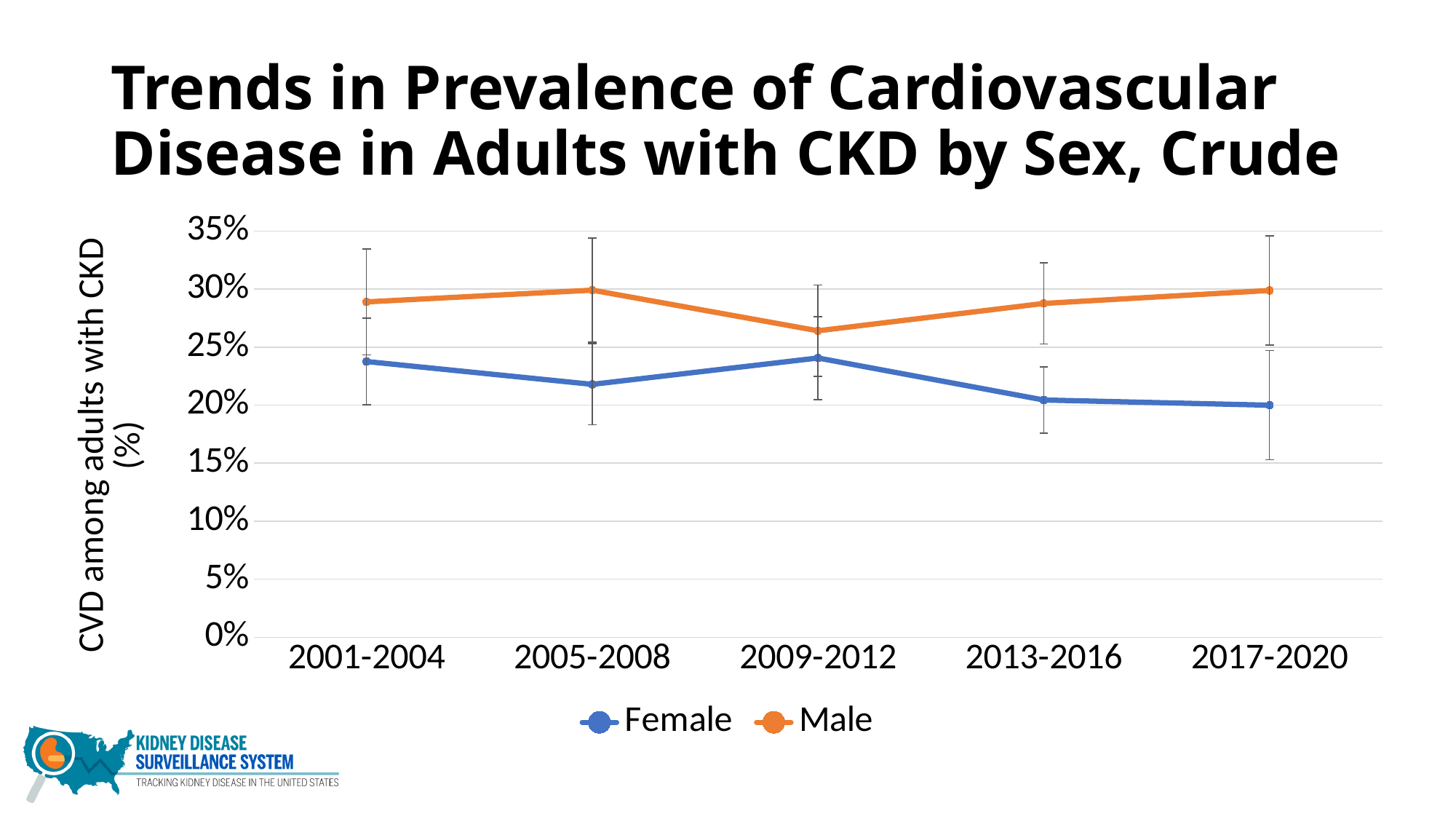
For the Male series, which period has the larger value, 2005-2008 or 2009-2012? 2005-2008 Is the Male value for 2001-2004 greater or less than 25%? greater Which series has the lower value in 2001-2004, Female or Male? Female In which period is the Male value lowest? 2009-2012 Is the Male value for 2009-2012 greater or less than 25%? greater Does the Female series rise or fall from 2009-2012 to 2017-2020? Fall What colour is the Male line? Orange How many series does the legend list? 2 Is the Female value for 2017-2020 greater or less than 25%? less What kind of chart is shown on the slide? Line chart How many time periods are shown on the x axis? 5